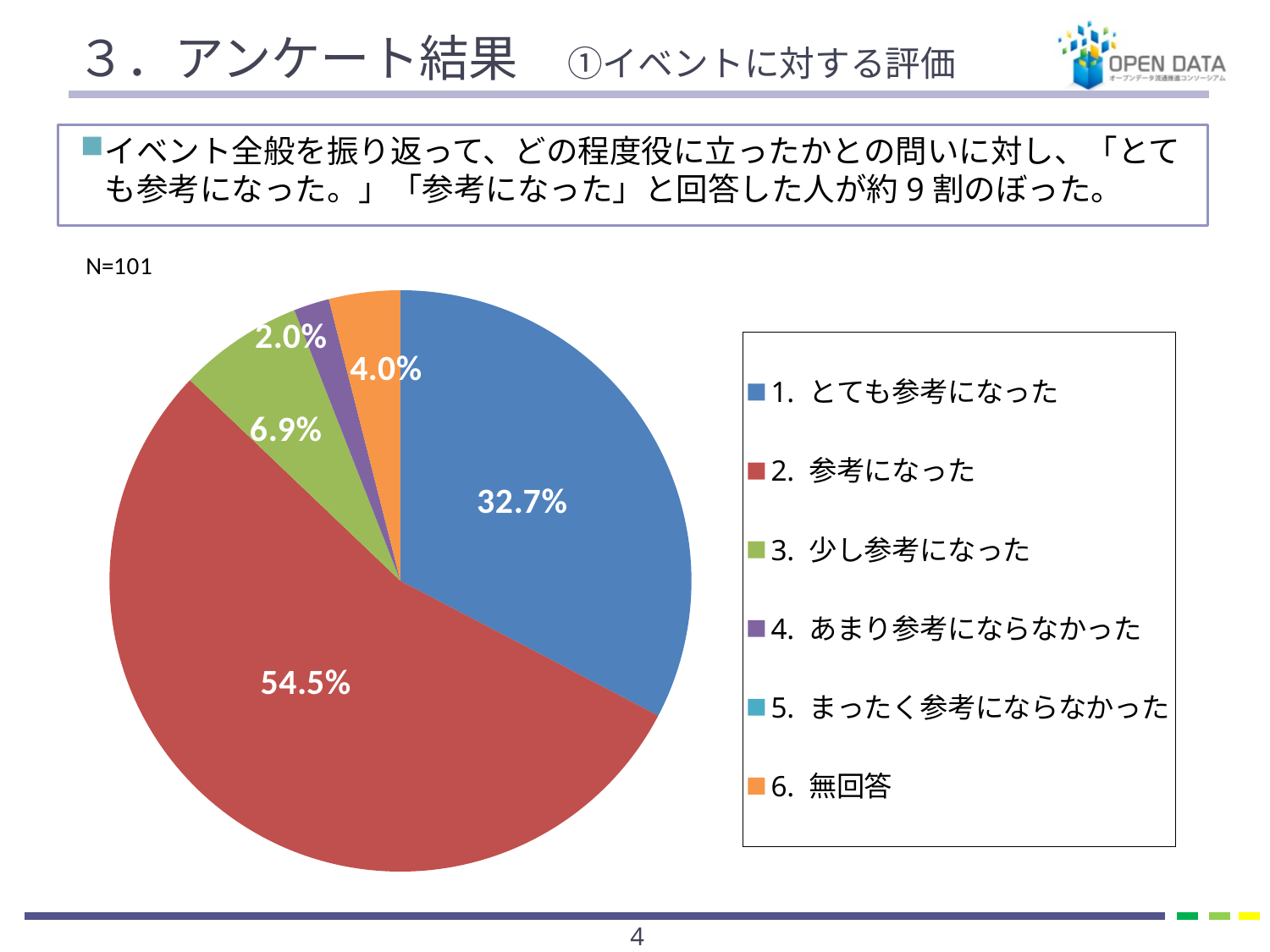
What percentage of respondents answered 「1. とても参考になった」? 32.7% What type of chart is shown on the slide? Pie chart What percentage of respondents answered 「3. 少し参考になった」? 6.9% What percentage of respondents answered 「6. 無回答」? 4.0% How many response categories does the legend list? 6 Which is larger, the share for 「3. 少し参考になった」 or the share for 「6. 無回答」? 3. 少し参考になった How many percentage points larger is the share for 「2. 参考になった」 than for 「1. とても参考になった」? 21.8 What percentage of respondents answered 「2. 参考になった」? 54.5% What percentage of respondents answered 「4. あまり参考にならなかった」? 2.0% Which of the labelled slices is the smallest? 4. あまり参考にならなかった Which response category has the largest share of the pie? 2. 参考になった What is the combined share of 「1. とても参考になった」 and 「2. 参考になった」? 87.2%